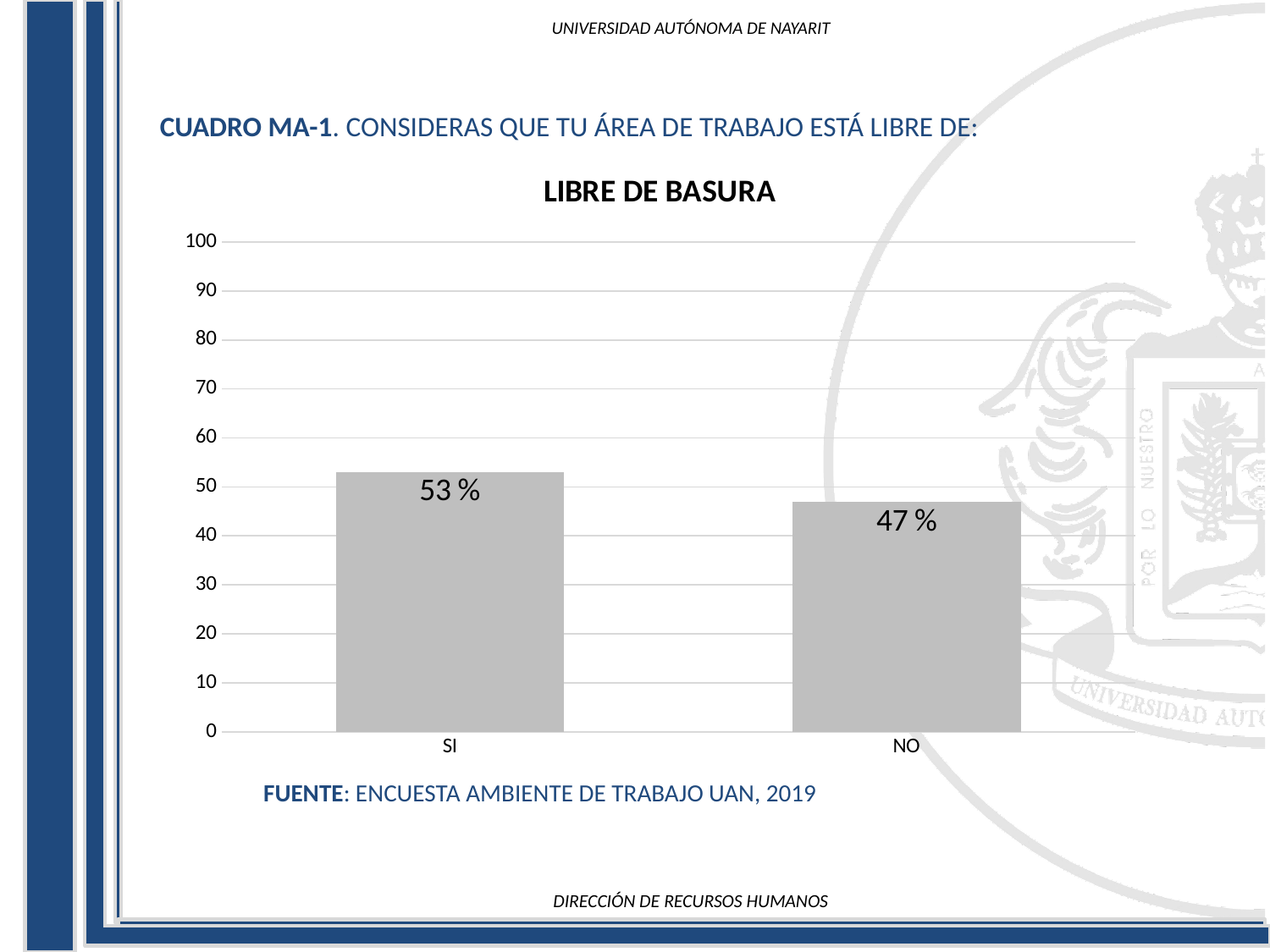
How many categories are shown on the x axis? 2 What is the value for NO? 47 % Is the value for NO greater or less than 50? less What is the value for SI? 53 % What is the difference between the values for SI and NO? 6 % Is the value for SI greater or less than 50? greater Which category has the highest value? SI Which is larger, the value for SI or the value for NO? SI What is the title of the chart? LIBRE DE BASURA What is the maximum value shown on the y axis? 100 What kind of chart is shown? bar chart Which category has the lowest value? NO